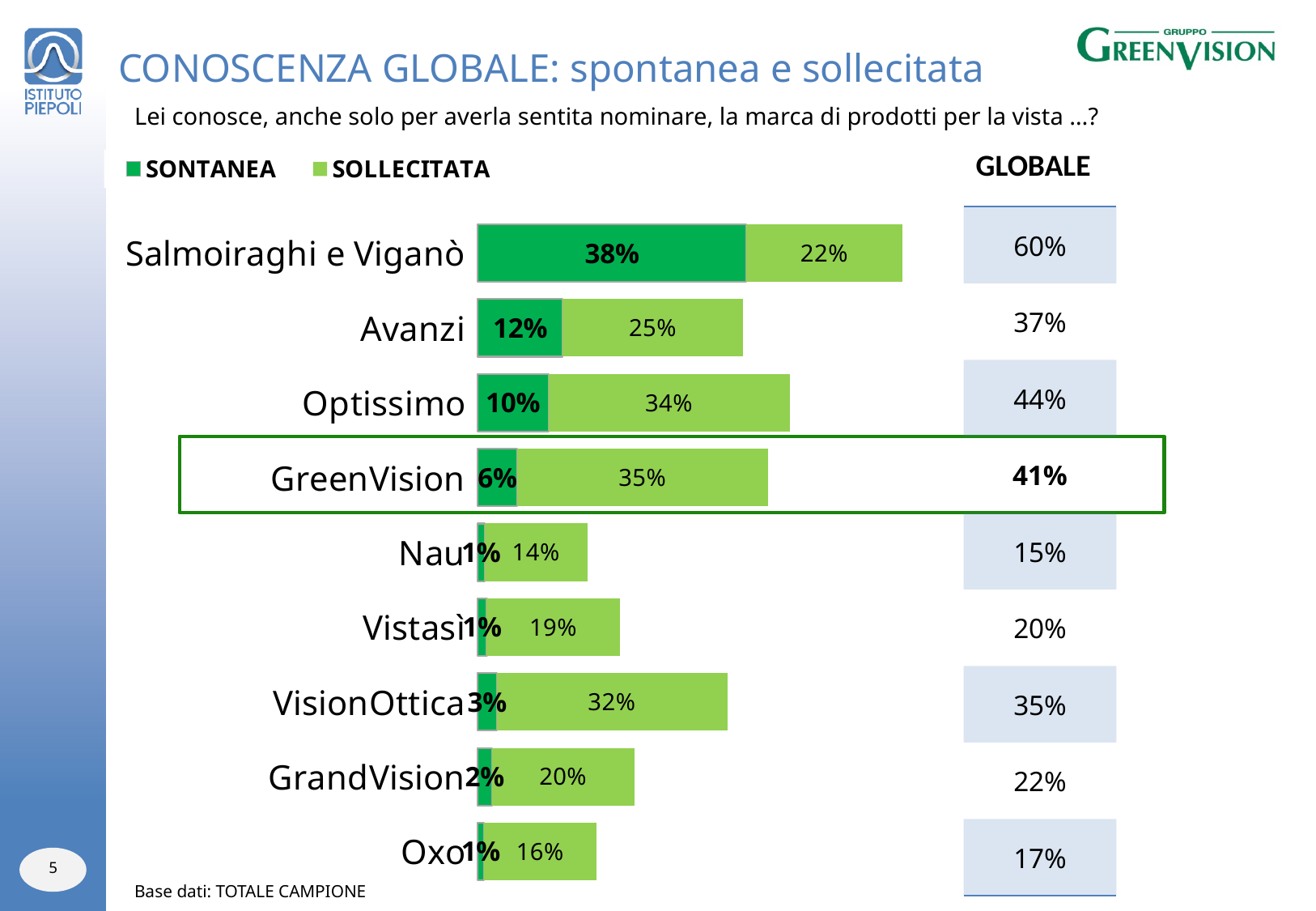
What is the difference between the SOLLECITATA values for GreenVision and Salmoiraghi e Viganò? 13% What is the SOLLECITATA value for Optissimo? 34% What is the SONTANEA value for Salmoiraghi e Viganò? 38% What is the SOLLECITATA value for GreenVision? 35% What kind of chart is shown on the slide? Stacked bar chart How many brands are shown in the chart? 9 Which brand has the highest SONTANEA value? Salmoiraghi e Viganò Which brand has the lowest SOLLECITATA value? Nau How many series does the legend list? 2 What is the total of the stacked bar for VisionOttica? 35% What is the SONTANEA value for Avanzi? 12% Which is larger, the SONTANEA value for Optissimo or for GreenVision? Optissimo